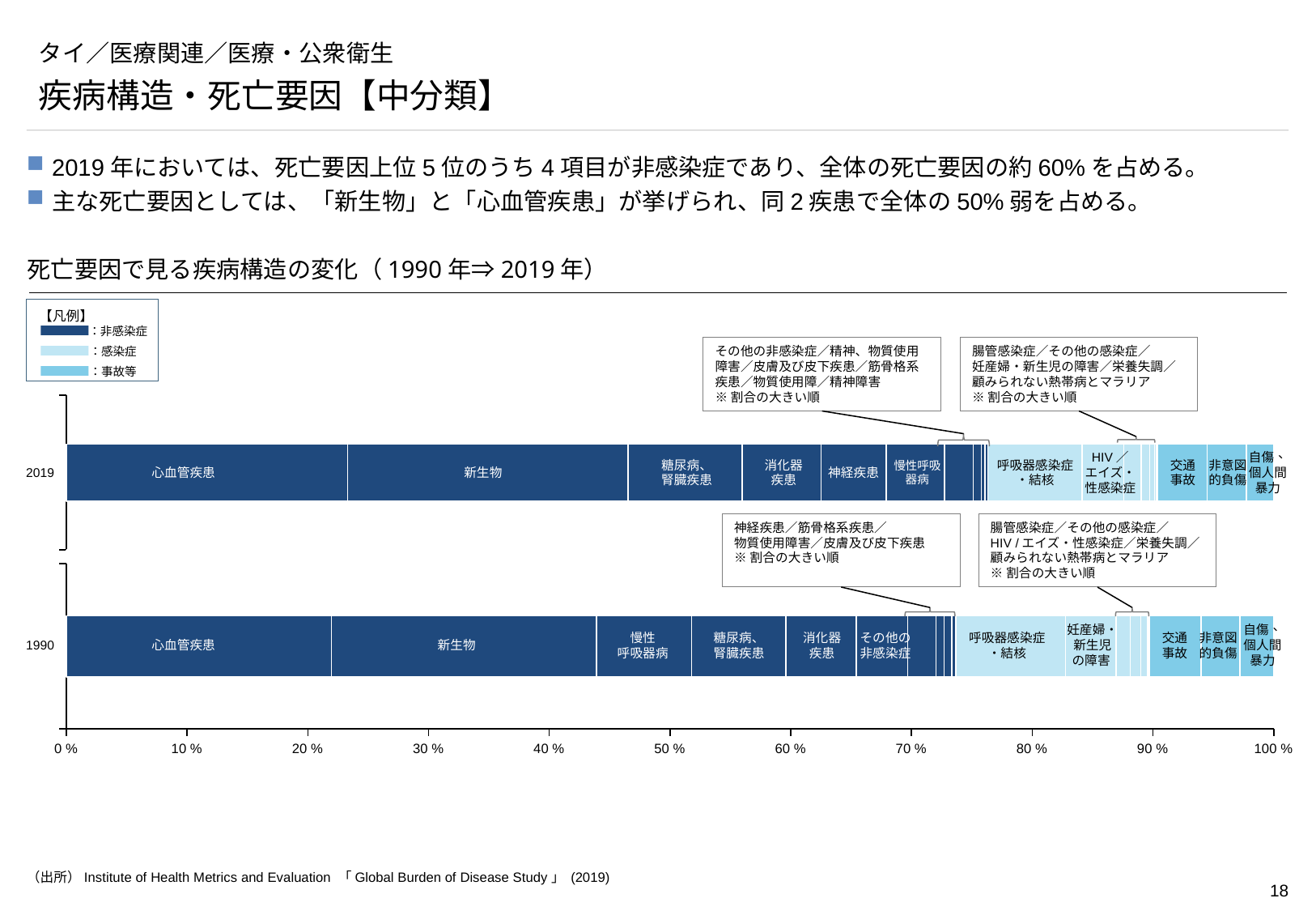
Which cause of death is the rightmost segment in both the 2019 and 1990 bars? 自傷、個人間暴力 What kind of chart is shown on the slide? Stacked bar chart What are the three legend entries of the chart? 非感染症、感染症、事故等 In the 2019 bar, is the share of 心血管疾患 greater or less than 20%? greater How many years (bars) does the chart compare? 2 How many categories does the legend (凡例) list? 3 In the 2019 bar, is the share of 心血管疾患 greater or less than 30%? less In the 2019 bar, which is larger: the share of 心血管疾患 or the share of 糖尿病、腎臓疾患? 心血管疾患 In the 1990 bar, which is larger: the share of 呼吸器感染症・結核 or the share of 交通事故? 呼吸器感染症・結核 In the 1990 bar, is the share of 新生物 greater or less than 30%? less